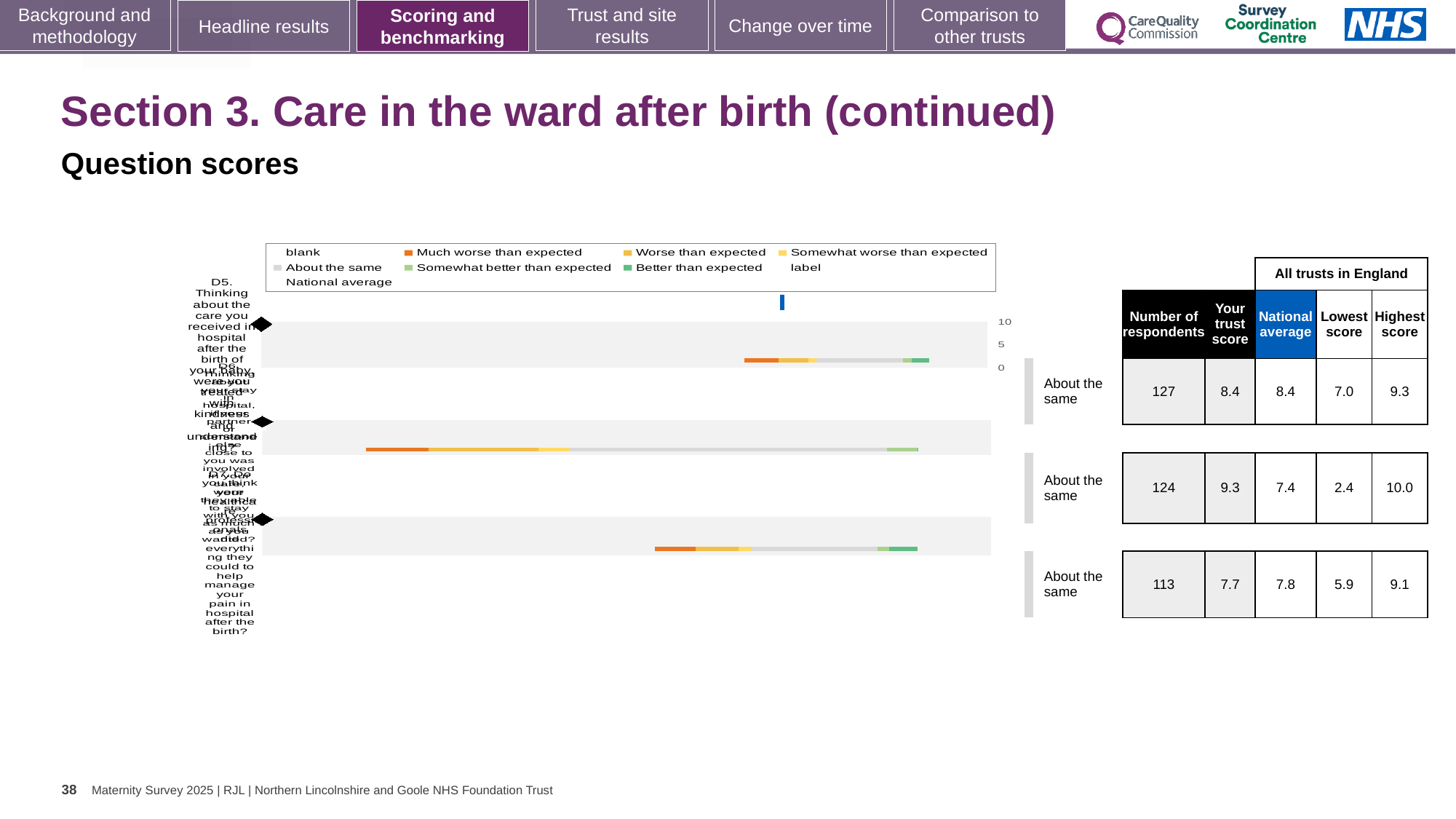
For the third (bottom) question row, which is larger: 'Your trust score' or the national average? the national average (7.8) What benchmark label is shown next to each of the three question rows? About the same What is the 'Your trust score' for the second (middle) question row? 9.3 What is the lowest score among all trusts in England for the second (middle) question row? 2.4 Which question row has the lowest number of respondents? the third (bottom) row, 113 What is the national average for the third (bottom) question row? 7.8 For the second (middle) question row, what is the difference between 'Your trust score' and the national average? 1.9 How many question rows (bars) are plotted in the chart? 3 What kind of chart is shown on the slide? bar chart What is the highest score among all trusts in England for the second (middle) question row? 10.0 Which question row has the highest 'Your trust score'? the second (middle) row, 9.3 What is the number of respondents for the first (top) question row? 127